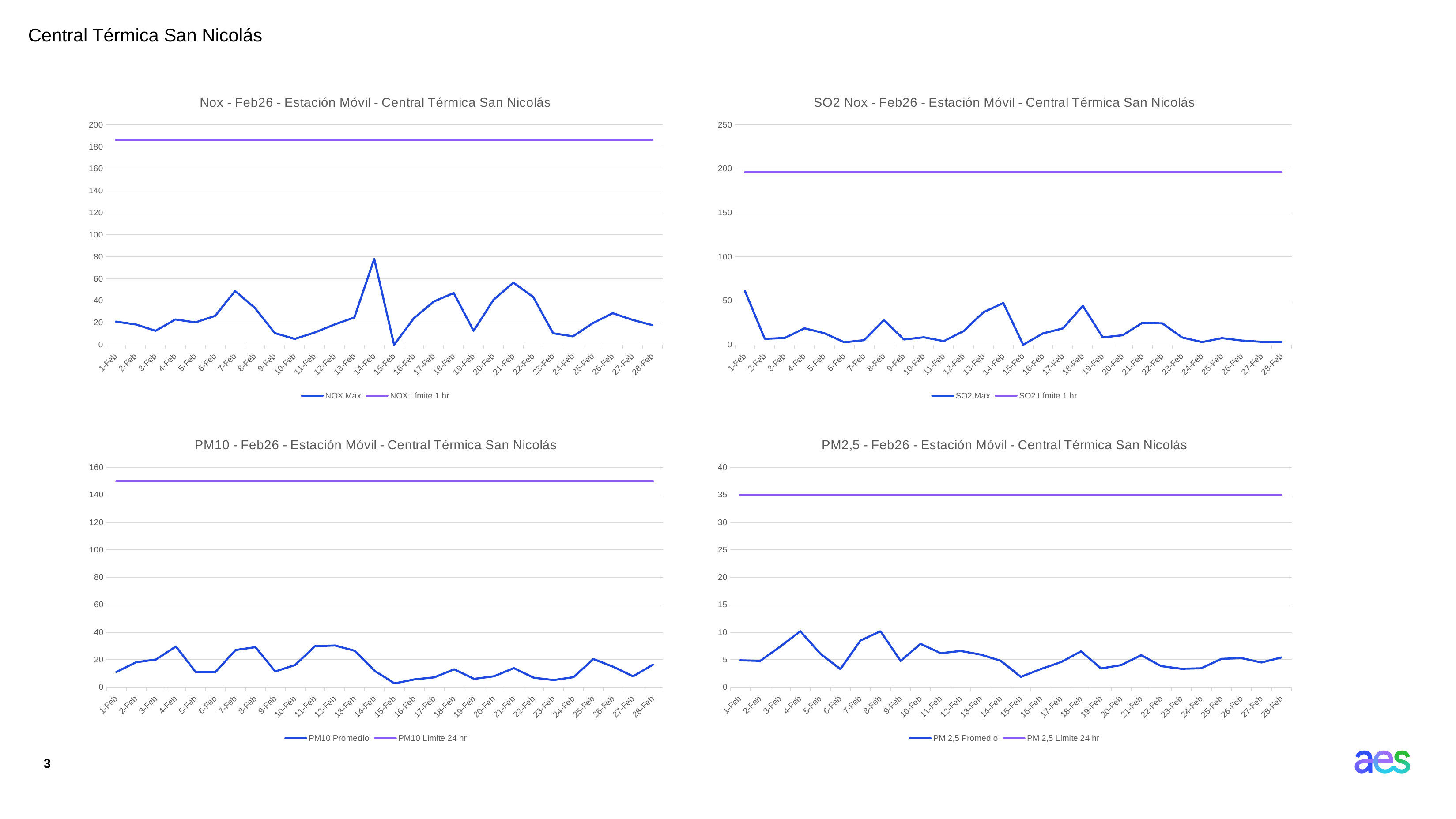
In the 'PM2,5 - Feb26' chart, which is larger, PM 2,5 Promedio on 4-Feb or on 6-Feb? 4-Feb In the 'SO2 Nox - Feb26' chart, is the SO2 Límite 1 hr line greater or less than 200? less How many series does the legend of the 'SO2 Nox - Feb26 - Estación Móvil - Central Térmica San Nicolás' chart list? 2 In the 'PM10 - Feb26' chart, is the PM10 Límite 24 hr line greater or less than 160? less In the 'Nox - Feb26' chart, on which date is NOX Max lowest? 15-Feb In the 'Nox - Feb26' chart, is the NOX Max value for 14-Feb greater or less than 60? greater In the 'Nox - Feb26' chart, on which date is NOX Max highest? 14-Feb How many dates are plotted along the x axis of the 'PM10 - Feb26 - Estación Móvil - Central Térmica San Nicolás' chart? 28 In the 'SO2 Nox - Feb26' chart, on which date is SO2 Max highest? 1-Feb In the 'PM10 - Feb26' chart, on which date is PM10 Promedio lowest? 15-Feb What kind of chart is the 'Nox - Feb26 - Estación Móvil - Central Térmica San Nicolás' chart? line chart In the 'PM2,5 - Feb26' chart, what is the value of the PM 2,5 Límite 24 hr line? 35